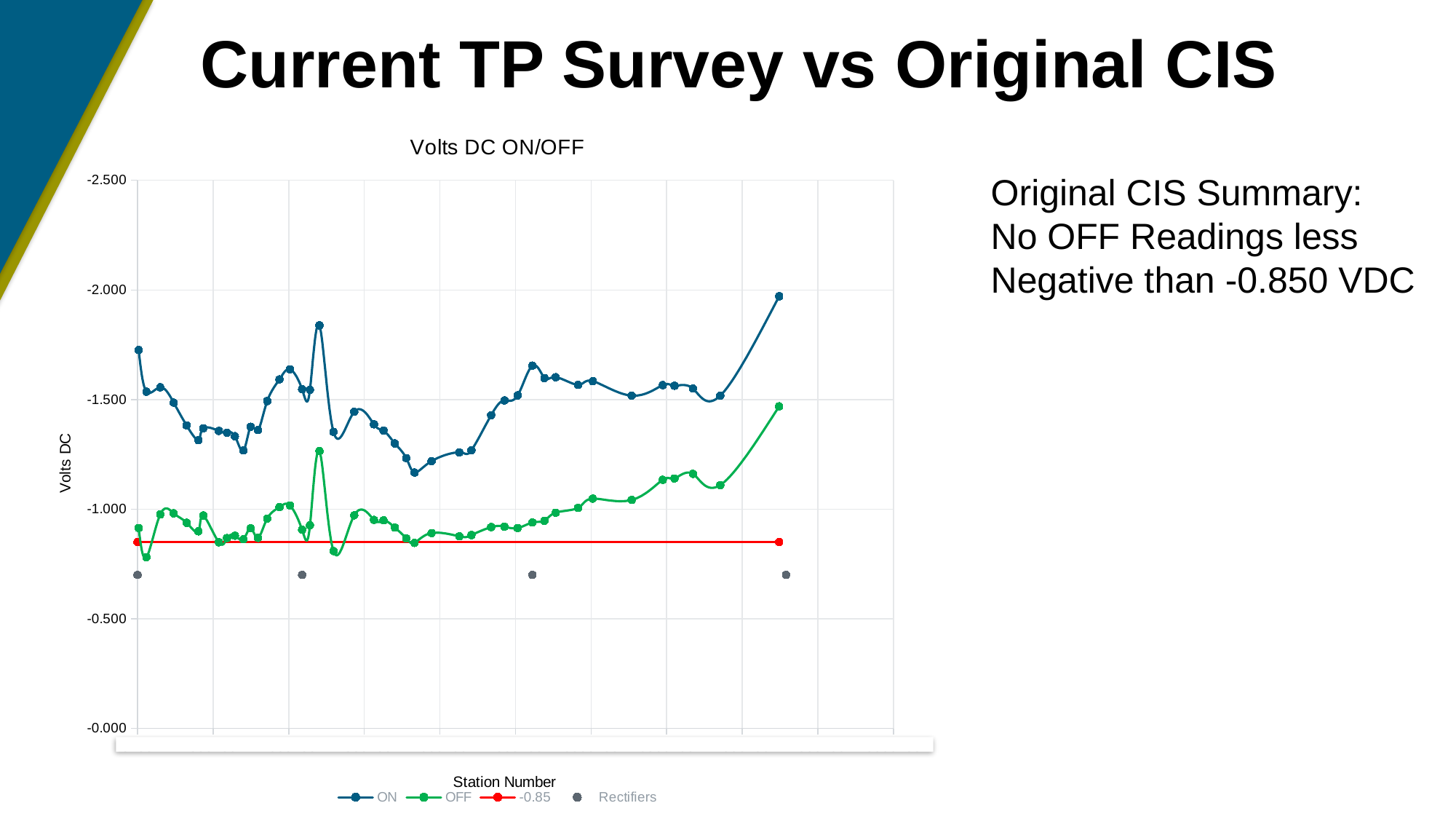
Does any ON reading reach -2.500 on the chart? no What kind of chart is shown on the slide? line chart Which series, ON or OFF, has the more negative readings across the chart? ON Which series is plotted in green? OFF What are the four entries in the chart legend? ON, OFF, -0.85, Rectifiers How many Rectifier markers are plotted on the chart? 4 Is the most negative ON reading (at the far right) more negative or less negative than -1.500? more negative Toward the right end of the chart, do the OFF readings become more negative or less negative? more negative How many series does the chart legend list? 4 Is the most negative OFF reading (at the far right) more negative or less negative than -1.000? more negative What is the title of the chart? Volts DC ON/OFF What value does the horizontal red reference line represent? -0.85